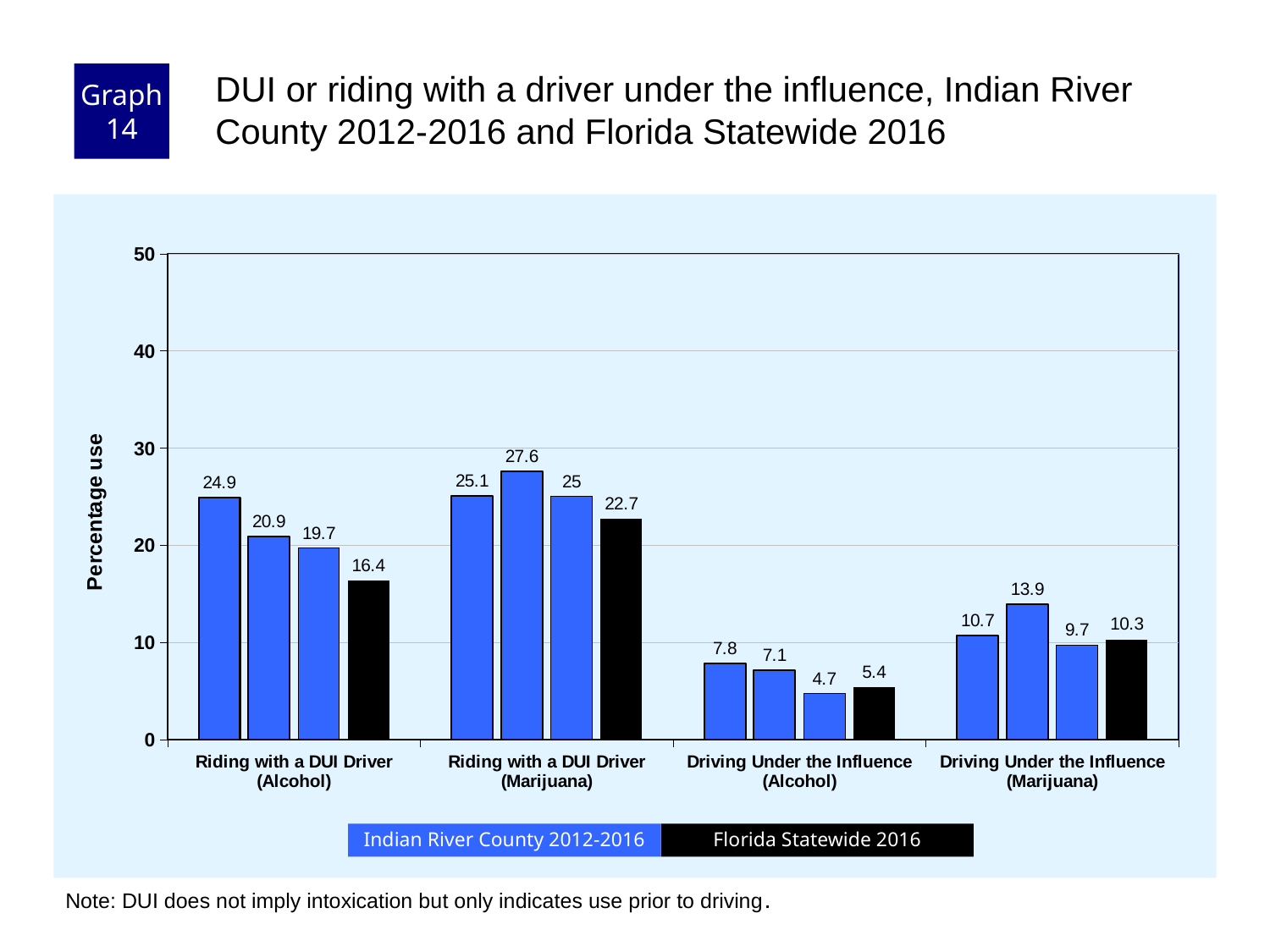
What is the Florida Statewide 2016 value for Driving Under the Influence (Marijuana)? 10.3 What is the difference between the Florida Statewide 2016 values for Riding with a DUI Driver (Marijuana) and Riding with a DUI Driver (Alcohol)? 6.3 For Florida Statewide 2016, which is larger: Driving Under the Influence (Alcohol) or Driving Under the Influence (Marijuana)? Driving Under the Influence (Marijuana) What kind of chart is shown on the slide? bar chart What is the Florida Statewide 2016 value for Riding with a DUI Driver (Alcohol)? 16.4 What is the highest value shown on the chart? 27.6 How many series does the legend list? 2 What is the value of the tallest Indian River County bar in the Driving Under the Influence (Marijuana) group? 13.9 What is the difference between the first Indian River County bar (24.9) and the Florida Statewide 2016 bar in the Riding with a DUI Driver (Alcohol) group? 8.5 What is the lowest value shown on the chart? 4.7 How many categories are shown on the x axis? 4 Is the Florida Statewide 2016 value for Riding with a DUI Driver (Marijuana) greater or less than 20? greater